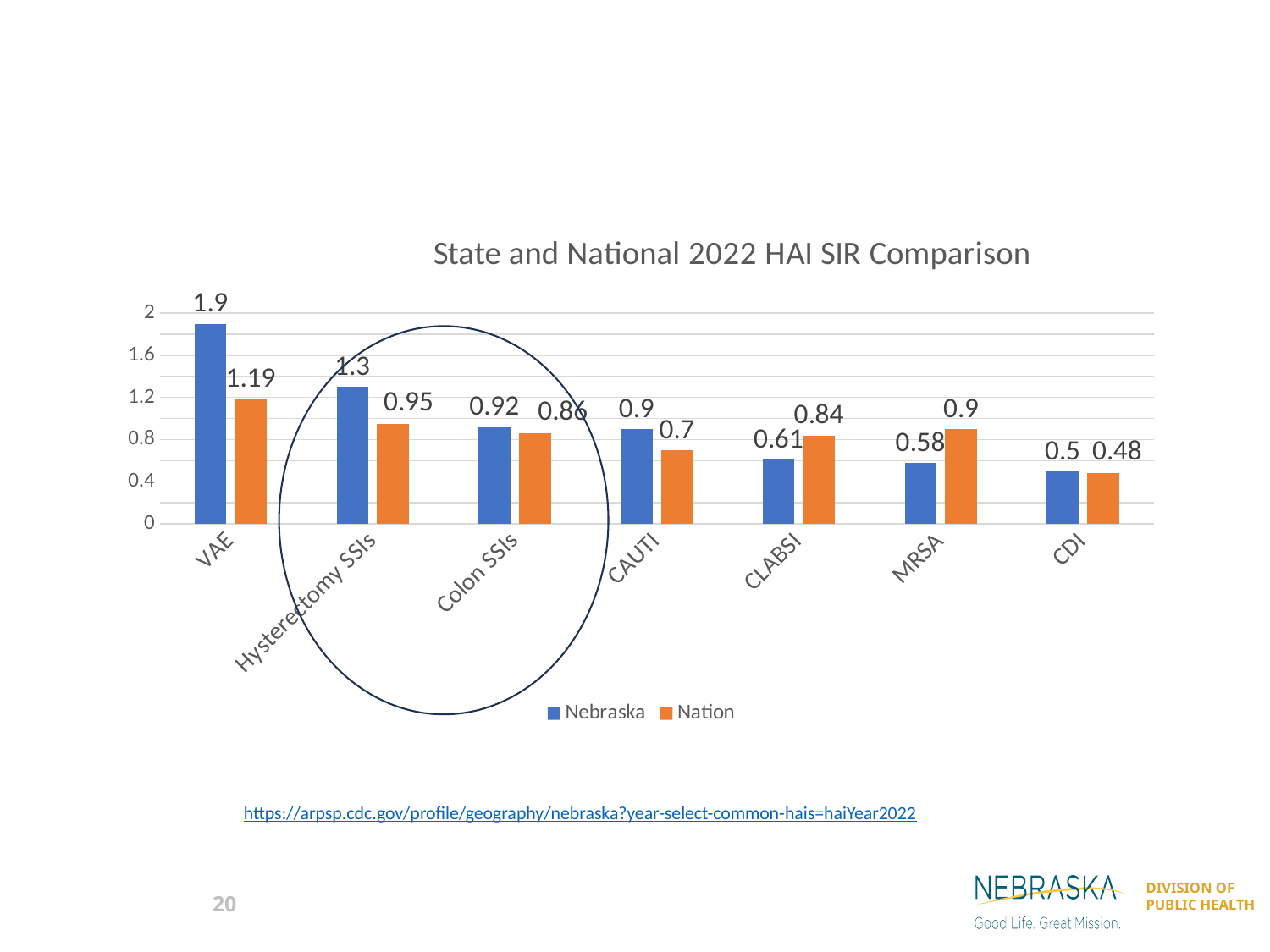
How many series does the legend list? 2 How many categories are shown on the x axis? 7 What is the difference between the Nebraska and Nation values for CAUTI? 0.2 What is the Nebraska value for VAE? 1.9 What kind of chart is shown on the slide? Bar chart What is the Nation value for Hysterectomy SSIs? 0.95 What is the title of the chart? State and National 2022 HAI SIR Comparison For MRSA, which is larger, the Nebraska value or the Nation value? Nation What is the Nebraska value for CLABSI? 0.61 Which category has the highest Nebraska value? VAE Which category has the lowest Nation value? CDI What is the Nation value for CDI? 0.48